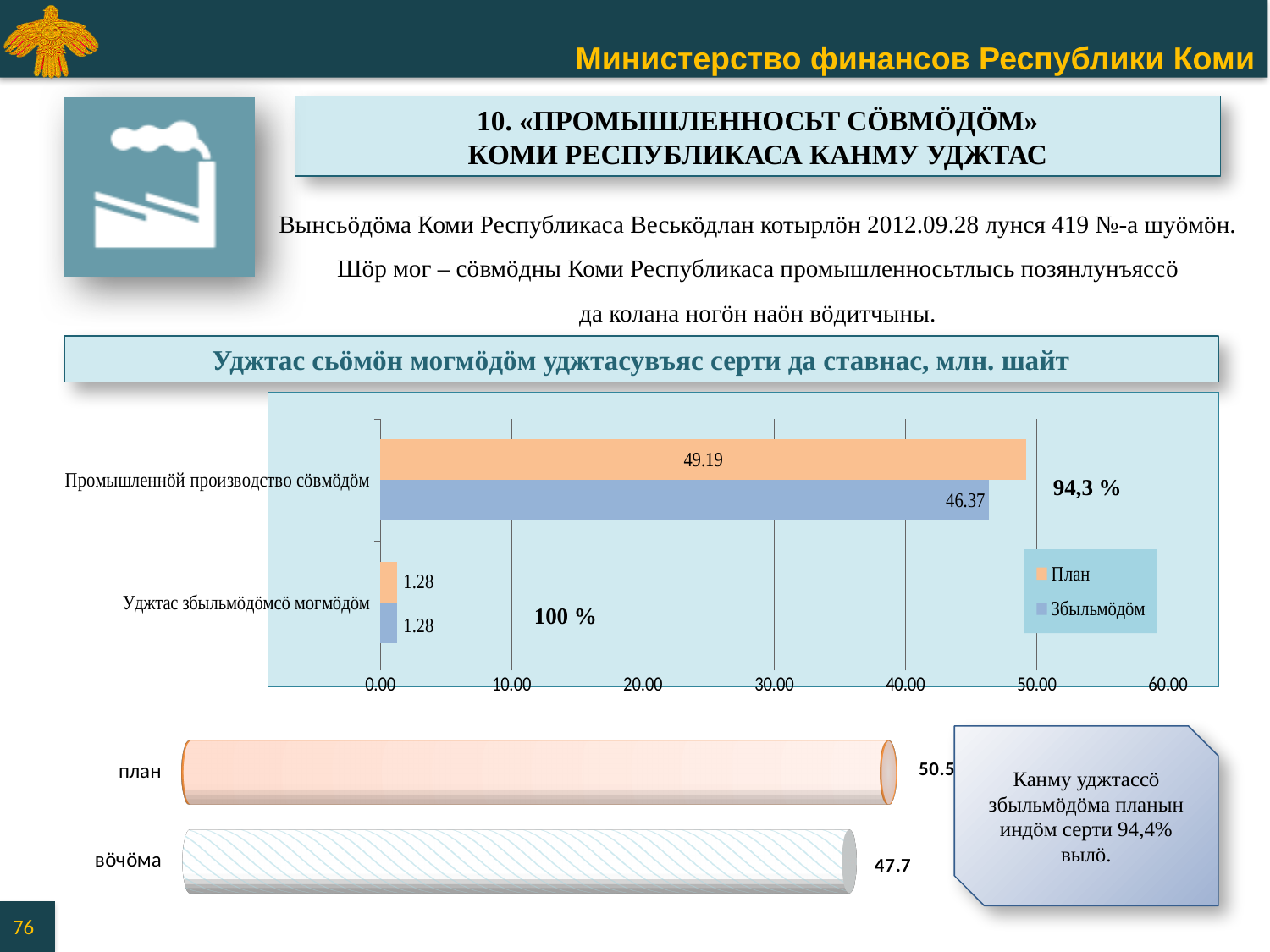
In the lower chart at the bottom of the slide, what is the difference between план and вӧчӧма? 2.8 In the upper bar chart, what is the План value for Промышленнӧй производство сӧвмӧдӧм? 49.19 How many categories are shown in the upper bar chart? 2 In the upper bar chart, what is the План value for Уджтас збыльмӧдӧмсӧ могмӧдӧм? 1.28 In the lower chart at the bottom of the slide, what is the value for план? 50.5 In the lower chart at the bottom of the slide, what is the value for вӧчӧма? 47.7 In the upper bar chart, what is the difference between the План and Збыльмӧдӧм values for Промышленнӧй производство сӧвмӧдӧм? 2.82 How many series does the legend of the upper bar chart list? 2 In the upper bar chart, what is the Збыльмӧдӧм value for Промышленнӧй производство сӧвмӧдӧм? 46.37 What kind of chart is the upper chart on the slide? bar chart In the upper bar chart, is the Збыльмӧдӧм value for Промышленнӧй производство сӧвмӧдӧм greater or less than 40.00? greater In the upper bar chart, which is larger for Промышленнӧй производство сӧвмӧдӧм: the План value or the Збыльмӧдӧм value? План